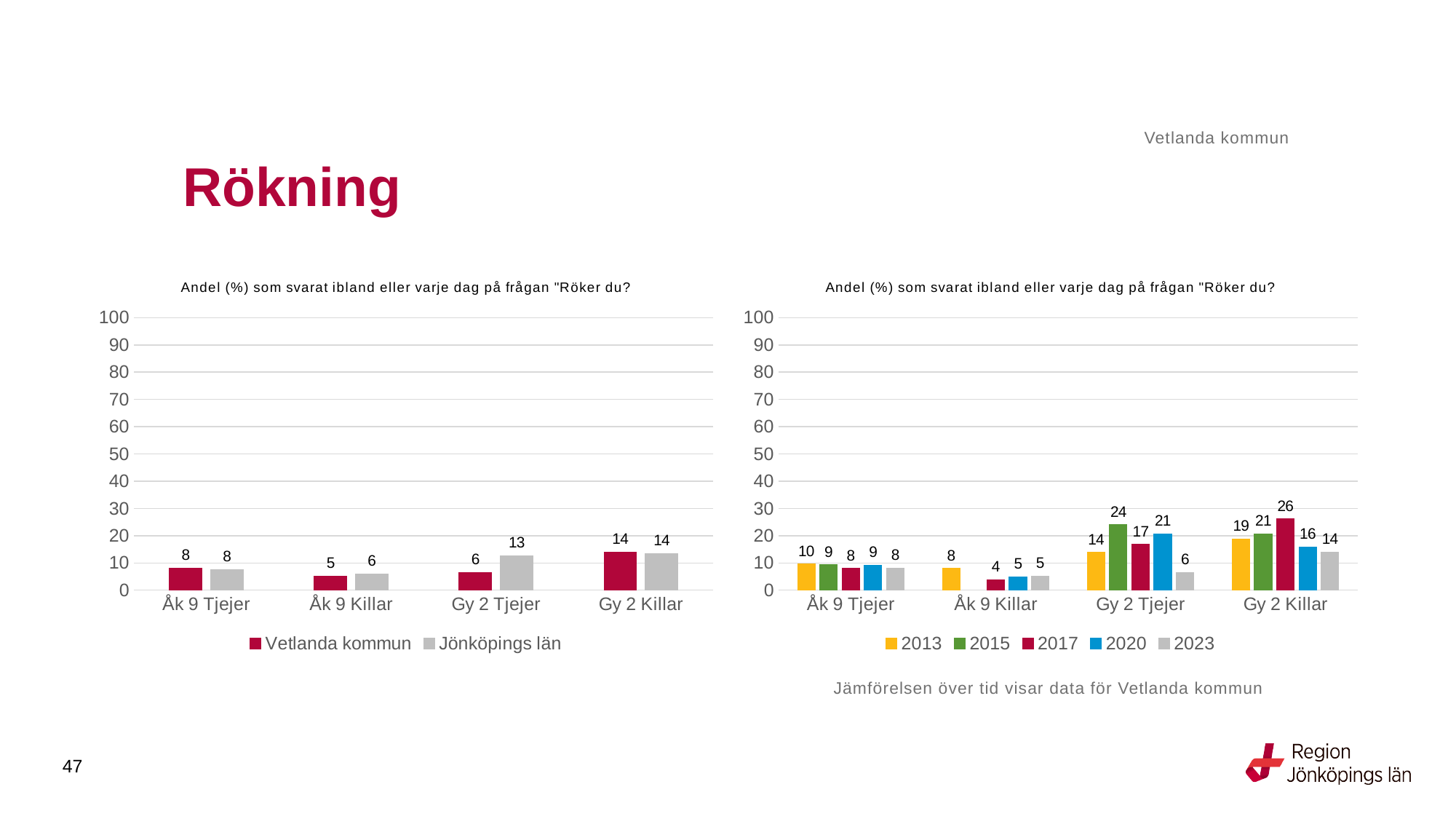
In the right chart, what is the value for 2023 for Gy 2 Tjejer? 6 In the left chart, how many series does the legend list? 2 In the left chart, what is the difference between Jönköpings län and Vetlanda kommun for Gy 2 Tjejer? 7 In the right chart, what is the difference between the 2015 and 2023 values for Gy 2 Tjejer? 18 In the left chart, what is the value for Jönköpings län for Gy 2 Tjejer? 13 In the left chart, what is the value for Vetlanda kommun for Gy 2 Killar? 14 In the right chart, which is larger for Åk 9 Killar: the 2013 value or the 2017 value? 2013 In the left chart, which category has the lowest value for Vetlanda kommun? Åk 9 Killar In the right chart, how many series does the legend list? 5 In the right chart, what is the value for 2017 for Gy 2 Killar? 26 In the right chart, which year has the highest value for Gy 2 Tjejer? 2015 What type of chart is the left chart? Bar chart